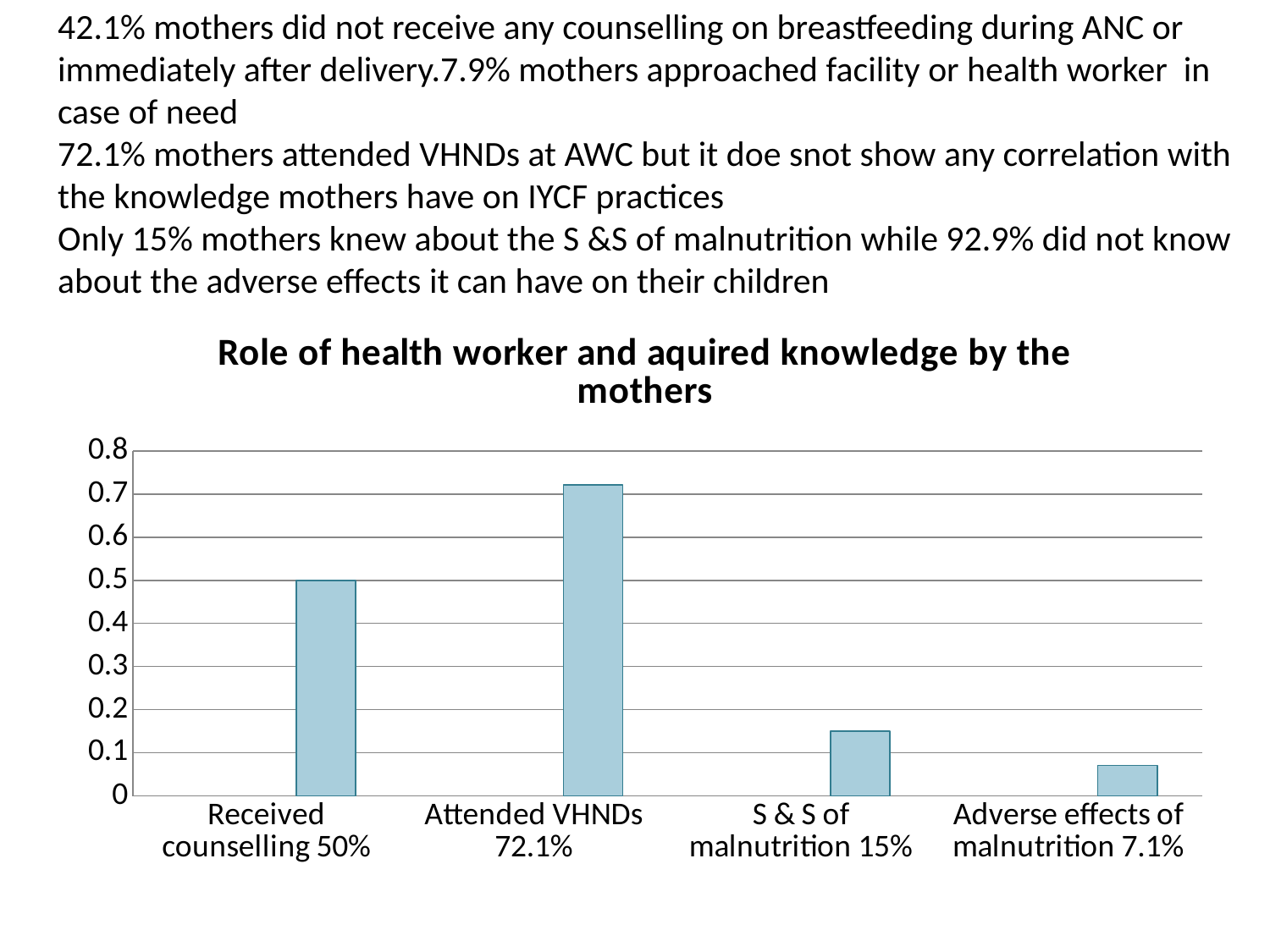
What percentage is shown in the category label for S & S of malnutrition? 15% Which category has the lowest bar in the chart? Adverse effects of malnutrition 7.1% Is the value for Adverse effects of malnutrition greater or less than 0.1? less What is the title of the chart? Role of health worker and aquired knowledge by the mothers What is the highest value shown on the vertical axis of the chart? 0.8 What percentage is shown in the category label for Attended VHNDs? 72.1% Is the value for Attended VHNDs greater or less than 0.7? greater What percentage is shown in the category label for Received counselling? 50% Which is larger, the bar for Received counselling or the bar for S & S of malnutrition? Received counselling Which category has the highest bar in the chart? Attended VHNDs 72.1% How many categories are plotted in the chart? 4 What kind of chart is shown on the slide? bar chart